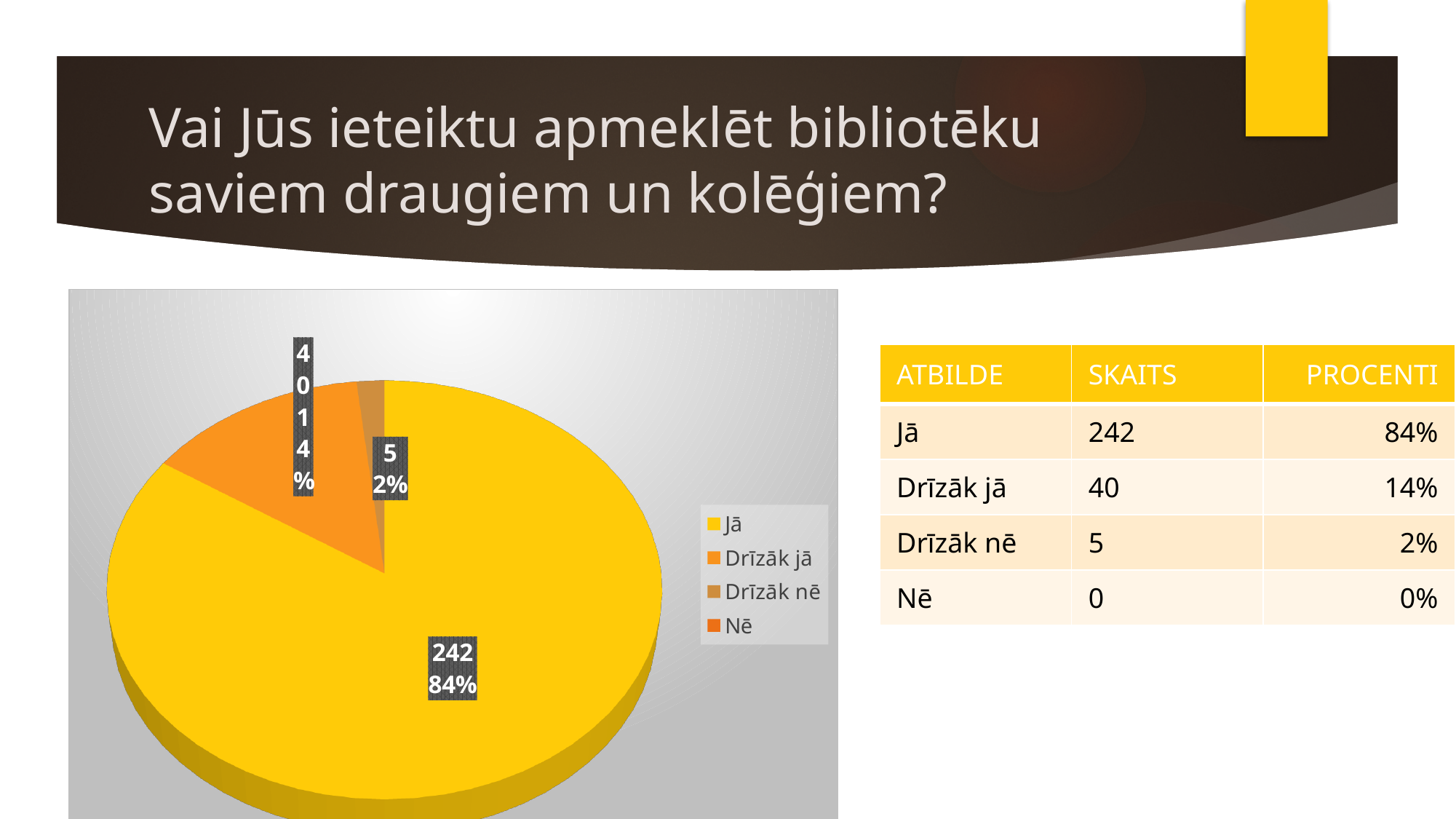
What kind of chart is shown on the slide? pie chart What is the difference in count between "Jā" and "Drīzāk jā" in the pie chart? 202 How many entries does the legend of the pie chart list? 4 Which category has the smallest share in the pie chart? Nē What is the count for the "Drīzāk nē" slice of the pie chart? 5 What percentage share does the "Jā" slice have in the pie chart? 84% What is the count for the "Drīzāk jā" slice of the pie chart? 40 Which is larger in the pie chart, "Drīzāk jā" or "Drīzāk nē"? Drīzāk jā What percentage share does the "Drīzāk jā" slice have in the pie chart? 14% What is the count for the "Jā" slice of the pie chart? 242 Which category has the largest slice in the pie chart? Jā What percentage share does the "Drīzāk nē" slice have in the pie chart? 2%